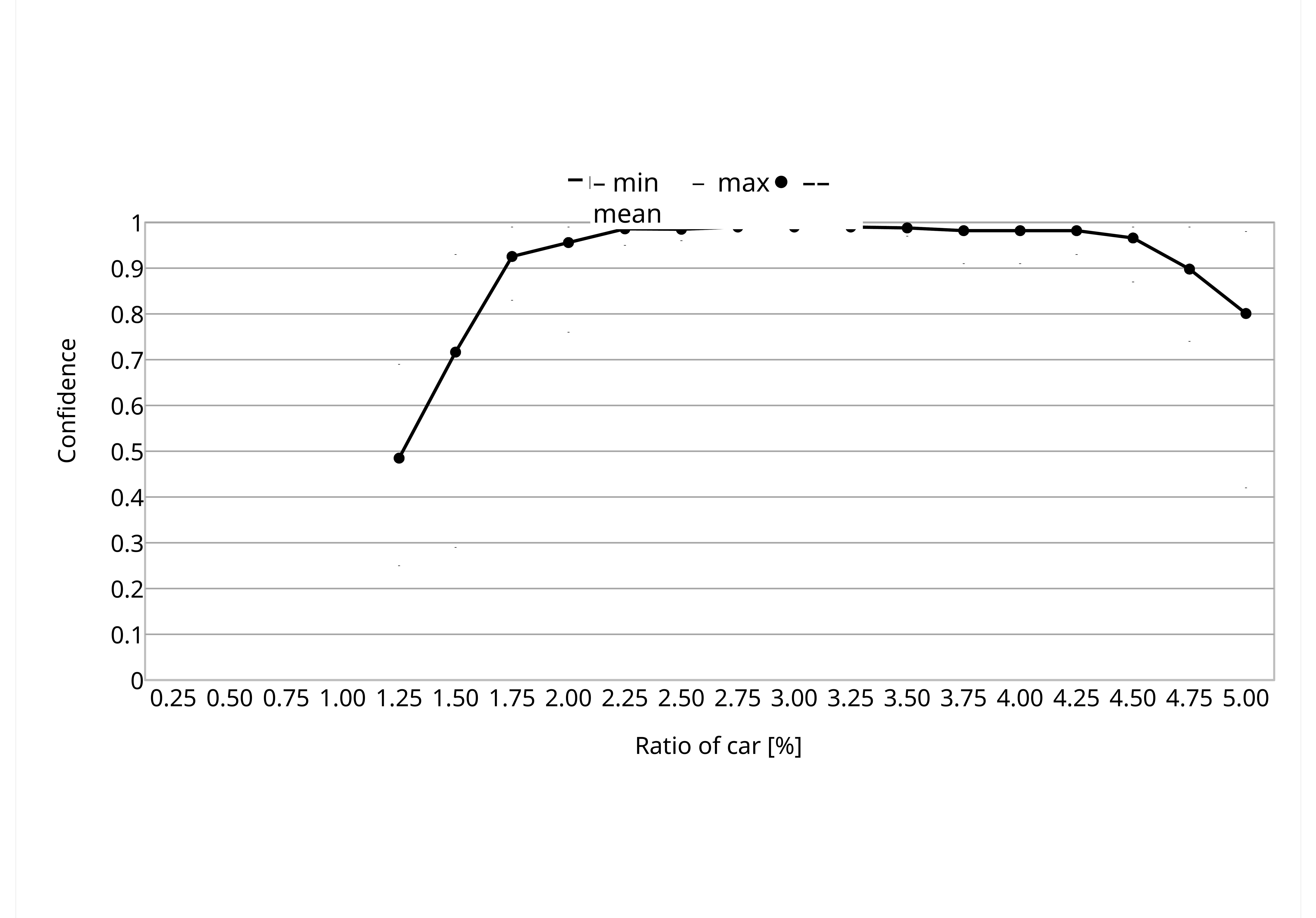
Does the mean confidence rise or fall as the ratio of car increases from 4.50 to 5.00? fall Is the mean confidence at a ratio of car of 5.00 greater or less than 0.9? less What kind of chart is shown on the slide? line chart What are the series names listed in the legend? min, max, mean Which has the larger mean confidence: a ratio of car of 1.25 or 5.00? 5.00 Is the mean confidence at a ratio of car of 1.50 greater or less than 0.6? greater At which ratio of car is the mean confidence lowest? 1.25 How many series does the legend list? 3 Is the mean confidence at a ratio of car of 1.25 greater or less than 0.6? less Does the mean confidence rise or fall as the ratio of car increases from 1.25 to 2.25? rise What is the label of the x axis? Ratio of car [%]